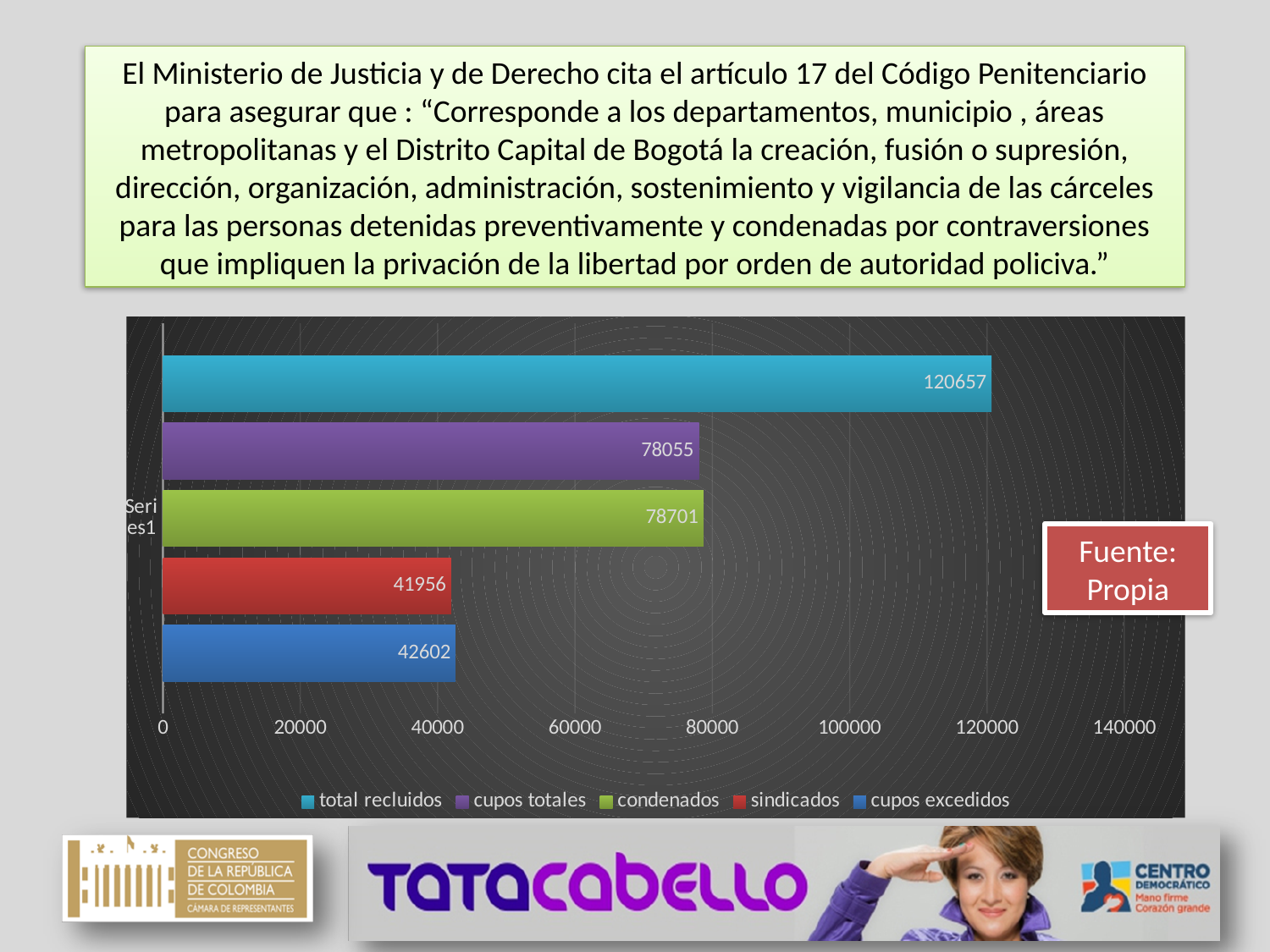
What kind of chart is shown on the slide? bar chart Is the value for total recluidos greater or less than 100000? greater What is the difference between condenados and cupos totales? 646 Which series has the highest value? total recluidos What is the value for total recluidos? 120657 What is the difference between total recluidos and cupos totales? 42602 What is the value for cupos excedidos? 42602 Which series has the lowest value? sindicados How many series does the legend list? 5 What is the value for cupos totales? 78055 What is the value for condenados? 78701 What is the value for sindicados? 41956